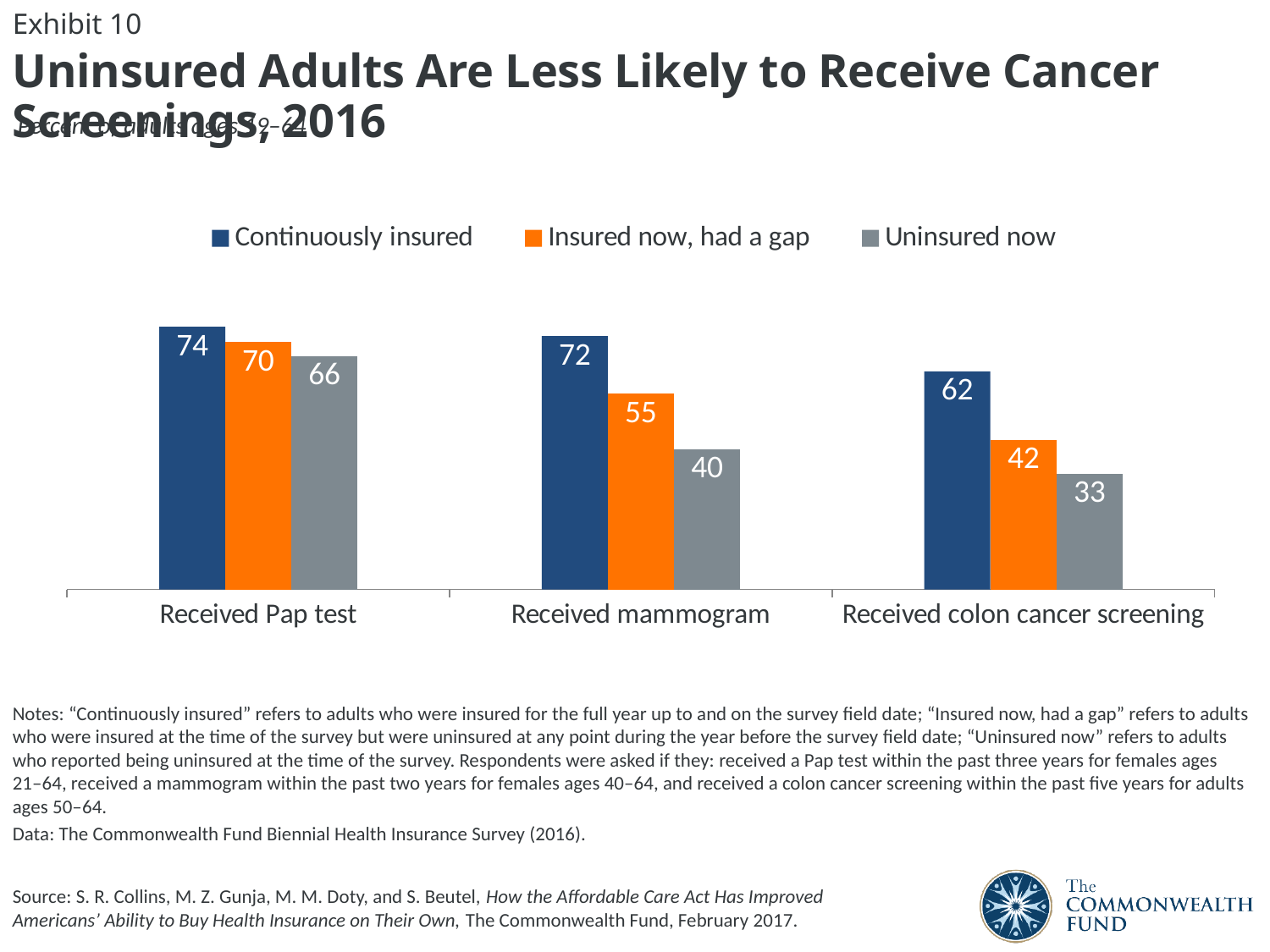
How many screening categories are shown on the x axis? 3 What kind of chart is shown on the slide? Bar chart Which screening category has the highest value for Continuously insured adults? Received Pap test Which screening category has the lowest value for Uninsured now adults? Received colon cancer screening What is the difference between Continuously insured and Insured now, had a gap adults who received colon cancer screening? 20 What is the value for Insured now, had a gap adults who received colon cancer screening? 42 What is the value for Uninsured now adults who received a mammogram? 40 Which is larger: the value for Insured now, had a gap adults who received a Pap test, or the value for Insured now, had a gap adults who received a mammogram? Received Pap test What is the difference between Continuously insured and Uninsured now adults who received a mammogram? 32 How many series does the legend list? 3 What is the value for Continuously insured adults who received a Pap test? 74 Which legend entry is shown in orange? Insured now, had a gap